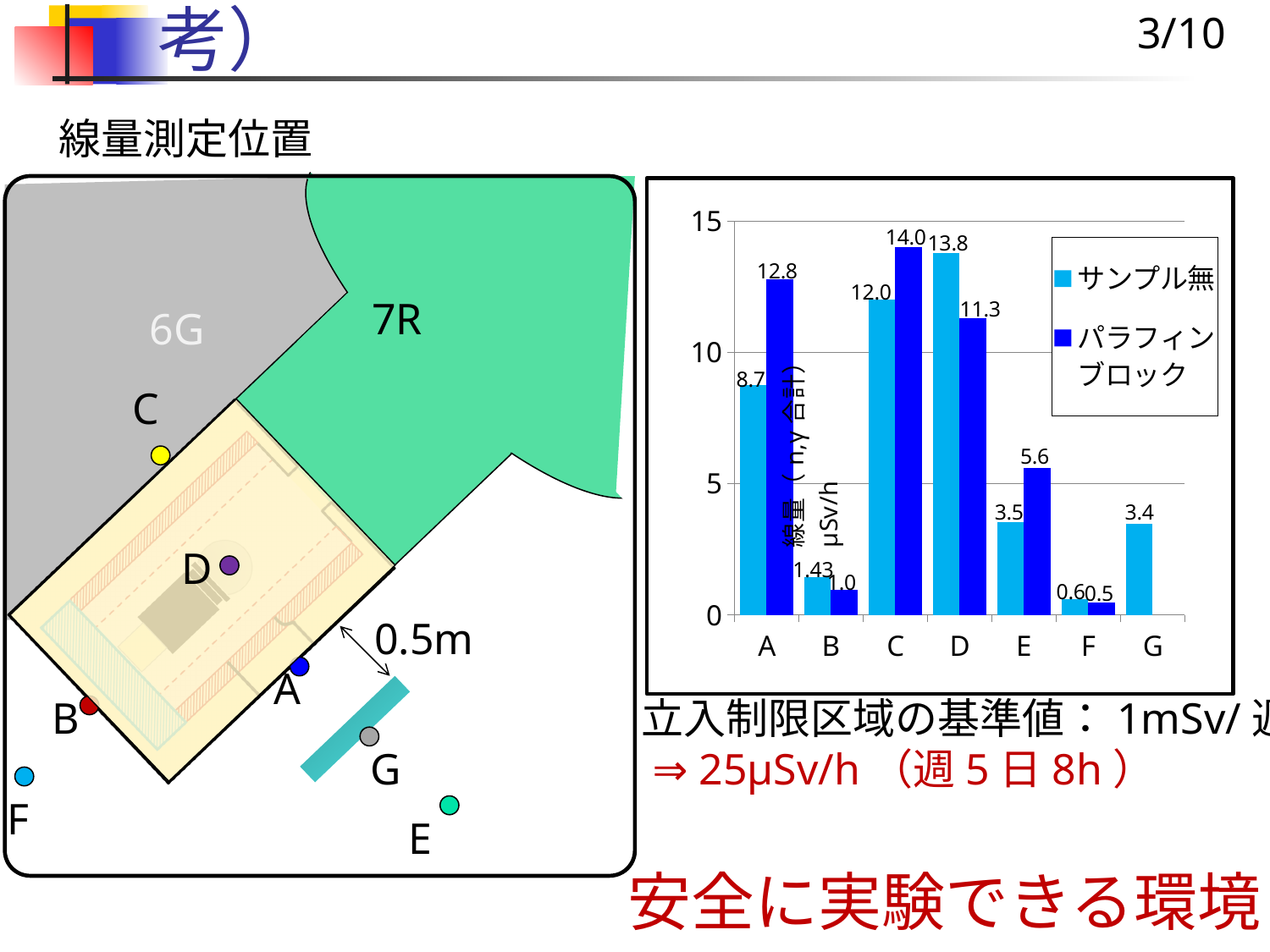
How many categories are shown on the x axis of the chart? 7 What is the value for パラフィンブロック at position C? 14.0 How many series does the chart legend list? 2 What unit is given on the y axis of the chart? μSv/h Which position has the highest value for the サンプル無 series? D What kind of chart is shown on the slide? bar chart Which position has the lowest value for the パラフィンブロック series? F What is the value for パラフィンブロック at position E? 5.6 At position D, which is larger: サンプル無 or パラフィンブロック? サンプル無 What is the value for サンプル無 at position A? 8.7 What is the value for サンプル無 at position D? 13.8 What is the difference between the パラフィンブロック and サンプル無 values at position A? 4.1